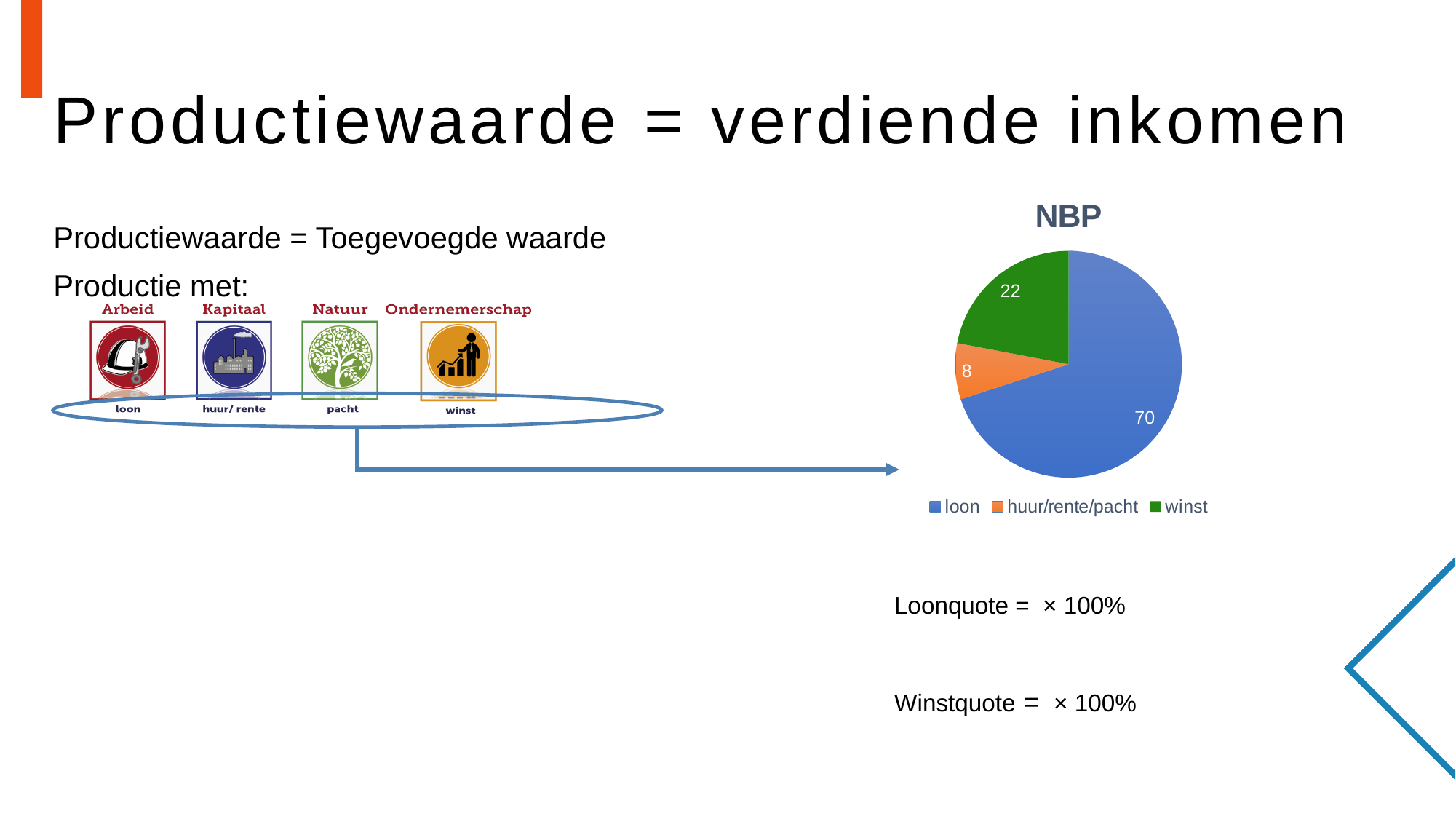
What is the value for winst in the NBP pie chart? 22 What is the value for huur/rente/pacht in the NBP pie chart? 8 What is the value for loon in the NBP pie chart? 70 What is the difference between the values for winst and huur/rente/pacht in the NBP pie chart? 14 Which category has the largest slice in the NBP pie chart? loon What colour is the loon slice in the NBP pie chart? blue What is the difference between the values for loon and winst in the NBP pie chart? 48 How many slices does the NBP pie chart have? 3 Which category has the smallest slice in the NBP pie chart? huur/rente/pacht Which is larger in the NBP pie chart, winst or huur/rente/pacht? winst What is the title of the pie chart? NBP What kind of chart is shown under the title NBP? pie chart